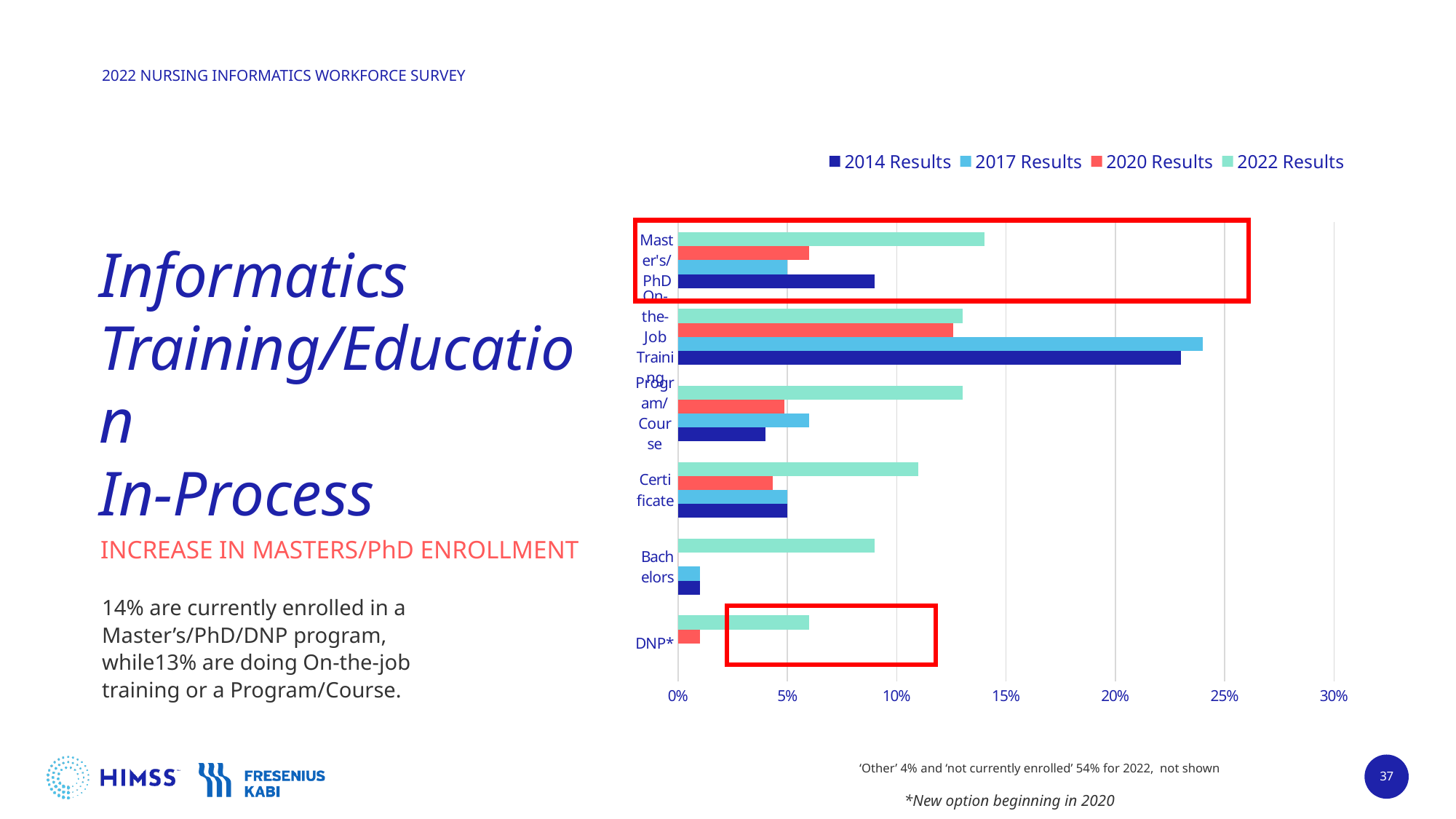
According to the slide text, what percentage are currently enrolled in a Master's/PhD/DNP program? 14% Is the 2014 Results value for On-the-Job Training greater or less than 20%? greater Which category has the highest value for 2017 Results? On-the-Job Training For Master's/PhD, which is larger: the 2022 Results value or the 2014 Results value? 2022 Results What type of chart is shown on the slide? bar chart Is the 2022 Results value for Bachelors greater or less than 5%? greater Which series is shown in red in the legend? 2020 Results For Program/Course, which is larger: the 2022 Results value or the 2020 Results value? 2022 Results How many series does the legend list? 4 Is the 2020 Results value for DNP* greater or less than 5%? less Which category has the lowest value for 2022 Results? DNP* How many categories are shown on the chart's vertical axis? 6